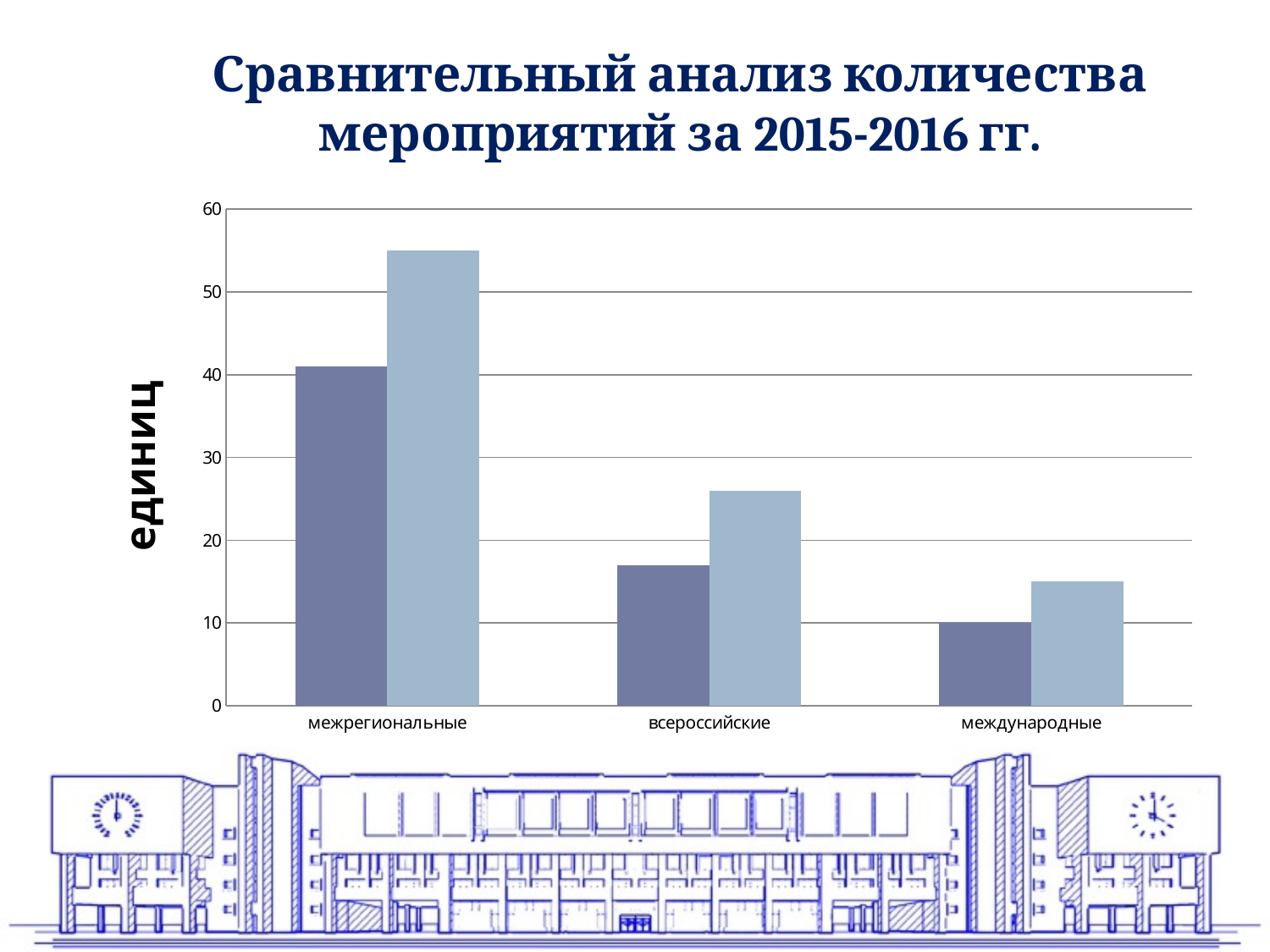
For the category всероссийские, which bar is taller, the darker one or the lighter one? the lighter one What kind of chart is shown on the slide? bar chart Which category has the tallest bar in the chart? межрегиональные What is the label on the vertical axis of the chart? единиц Is the value of the darker bar for всероссийские greater or less than 20? less Is the value of the lighter bar for международные greater or less than 20? less Is the value of the lighter bar for межрегиональные greater or less than 50? greater How many categories are shown on the x axis of the chart? 3 Which category has the shortest bar in the chart? международные Do the bar values rise or fall moving from left to right along the x axis? fall